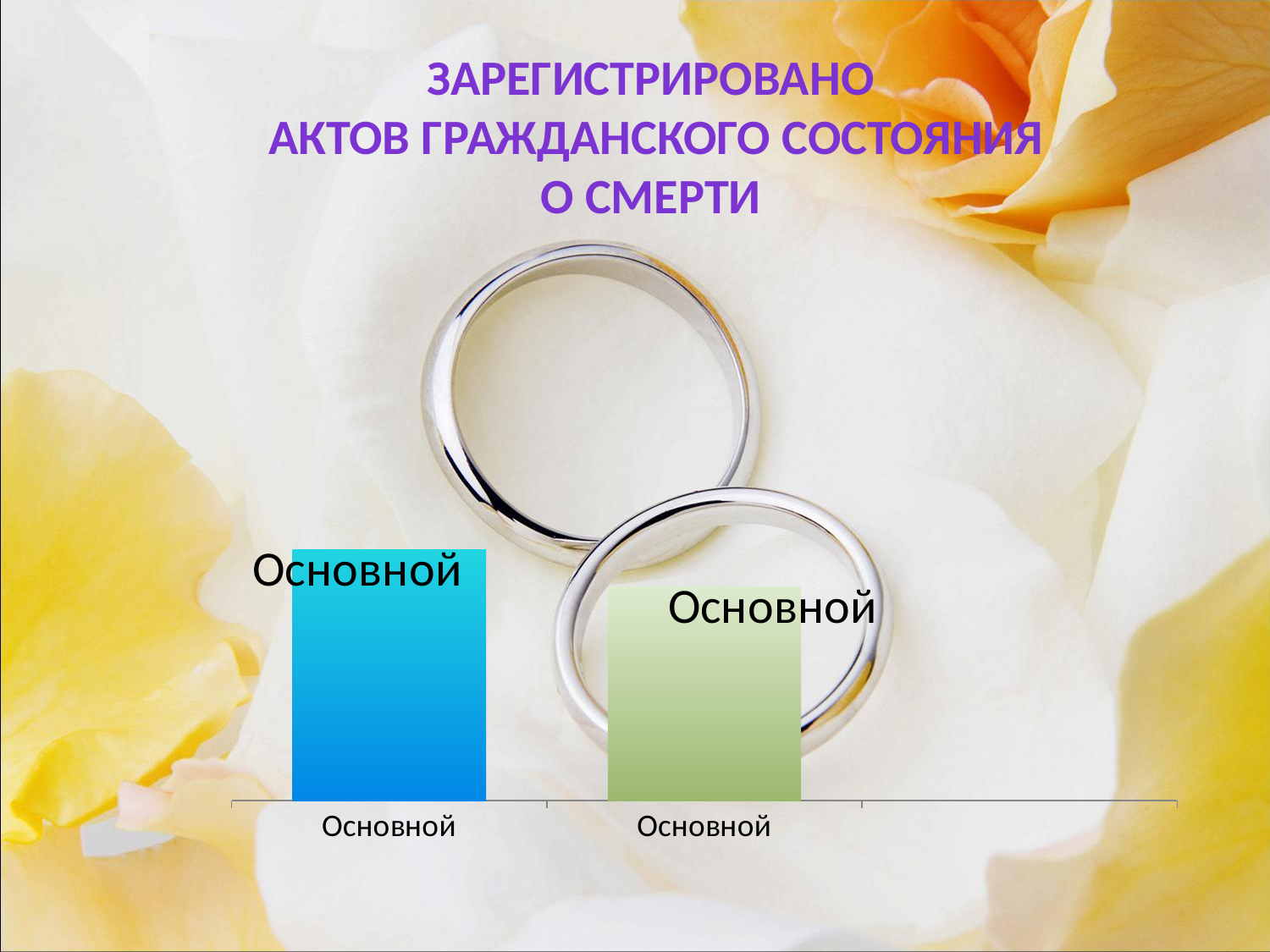
Which bar is the tallest in the chart? the left bar How many bars does the chart show? 2 Which bar is taller, the left bar or the right bar? the left bar Which bar is the shortest in the chart? the right bar Do the bar values fall or rise from left to right? fall What colour is the left bar of the chart? blue What is the title shown above the chart on the slide? ЗАРЕГИСТРИРОВАНО АКТОВ ГРАЖДАНСКОГО СОСТОЯНИЯ О СМЕРТИ What kind of chart is shown on the slide? bar chart